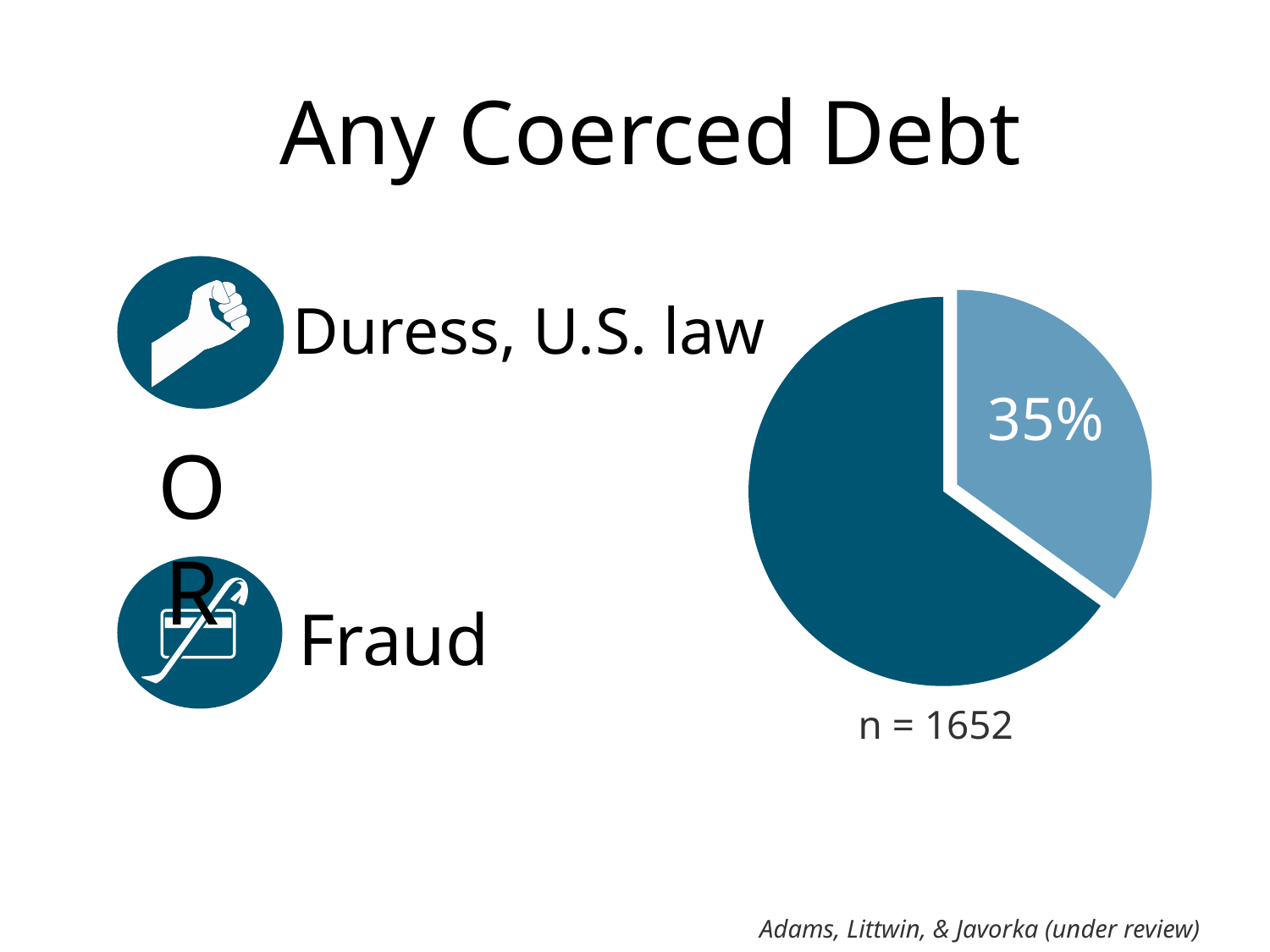
Which slice of the pie chart is larger, the light blue slice or the dark blue slice? the dark blue slice What is the title of the slide containing the pie chart? Any Coerced Debt What share of the pie does the light blue slice represent? 35% What kind of chart is shown on the slide? pie chart How many slices does the pie chart have? 2 What percentage is printed on the light blue slice of the pie chart? 35% Which slice of the pie chart is the smallest? the light blue slice (35%) What sample size (n) is printed below the pie chart? n = 1652